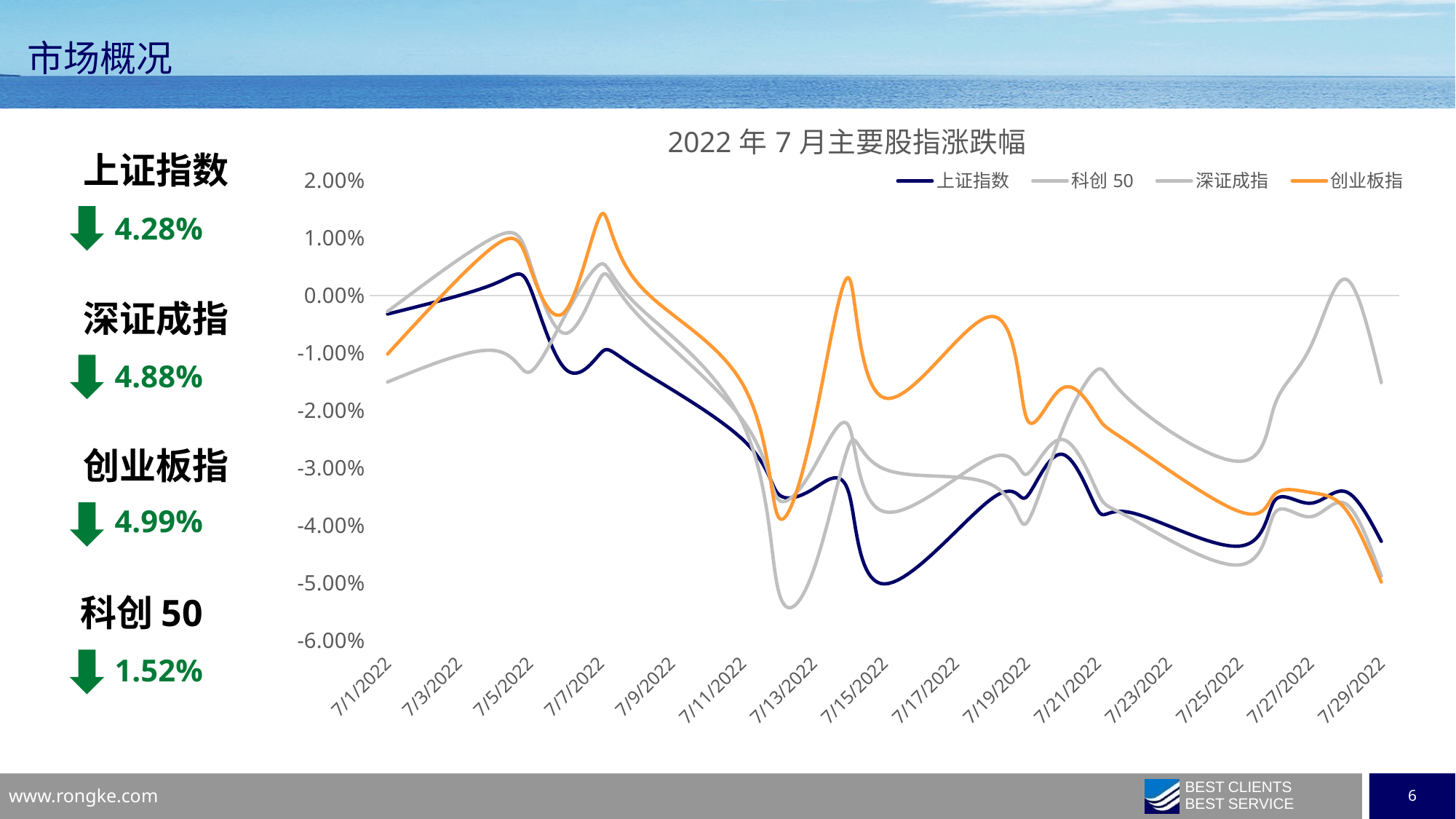
How many series does the chart legend list? 4 Which series is drawn in orange? 创业板指 On 7/29/2022, which is higher, 上证指数 or 创业板指? 上证指数 Is the value for 创业板指 at its peak around 7/7/2022 greater or less than 1.00%? greater What type of chart is shown on the slide? line chart Is the value for 创业板指 around 7/17/2022 greater or less than -1.00%? greater Around 7/17/2022, which is higher, 创业板指 or 上证指数? 创业板指 Is the value for 创业板指 on 7/29/2022 greater or less than -4.00%? less What is the title of the chart? 2022 年 7 月主要股指涨跌幅 How many date labels are shown on the x axis? 15 Does the 上证指数 line overall rise or fall from 7/1/2022 to 7/29/2022? fall